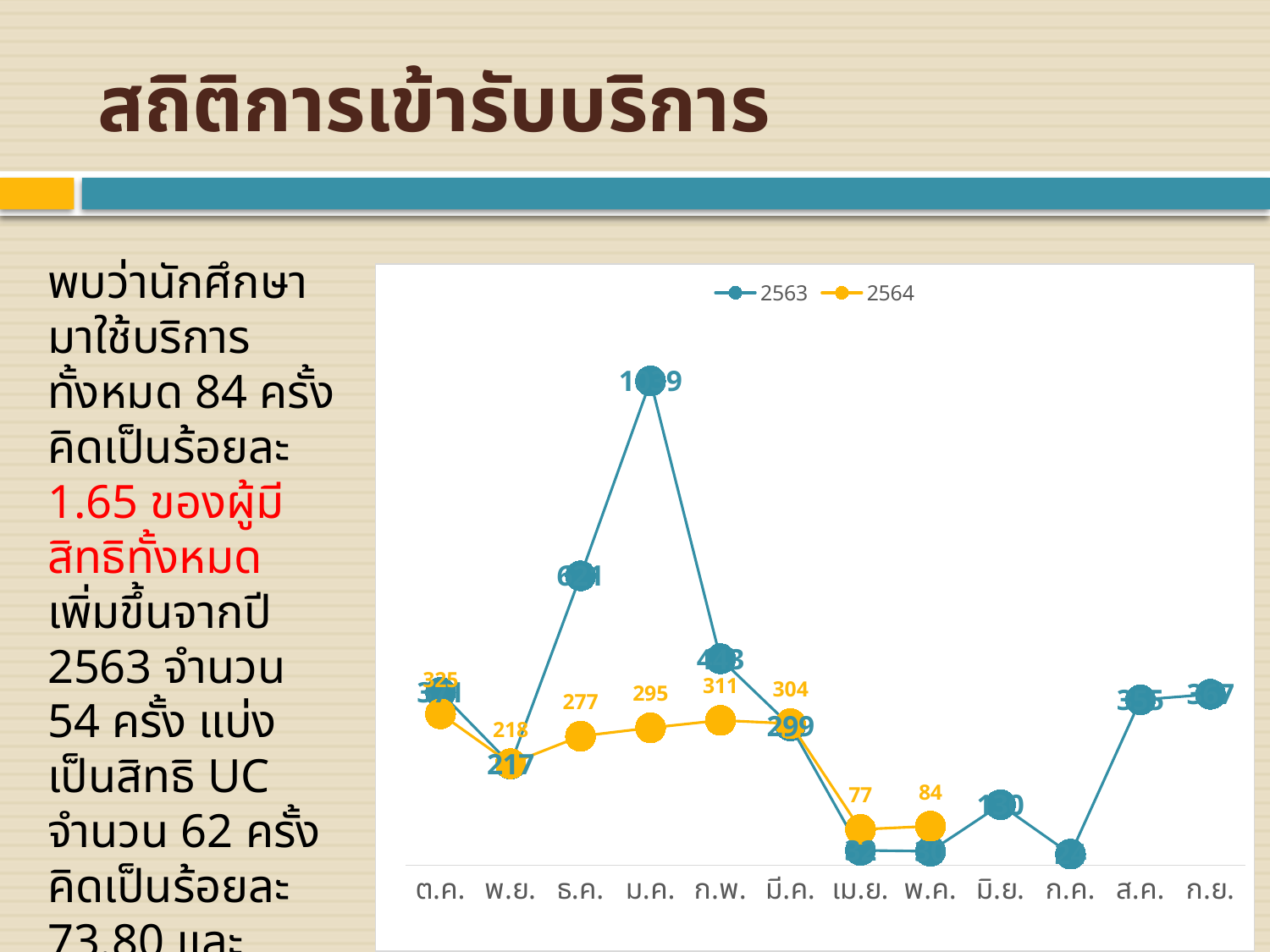
In which month is the 2564 series highest? ต.ค. What type of chart is shown on the slide? line chart In which month is the 2564 series lowest? เม.ย. What is the value for the 2564 series in ธ.ค.? 277 Which series has the higher value in ม.ค.? 2563 What is the value for the 2563 series in มี.ค.? 299 What is the difference between the 2564 values for พ.ค. and เม.ย.? 7 For the 2564 series, which is larger: ม.ค. or ธ.ค.? ม.ค. How many series does the legend list? 2 What is the value for the 2564 series in เม.ย.? 77 What is the value for the 2564 series in ก.พ.? 311 How many months are shown on the x axis? 12